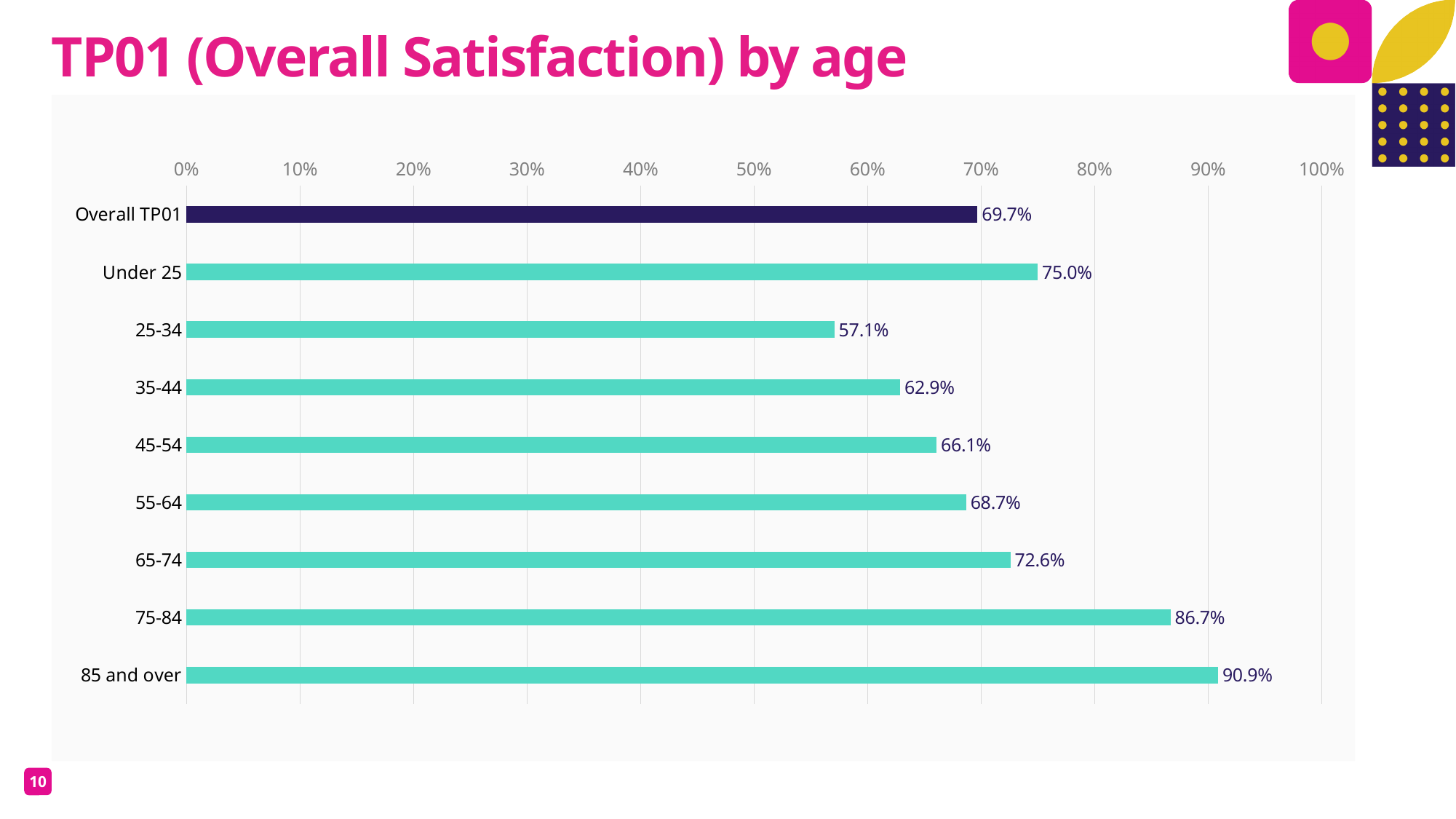
What kind of chart is shown on the slide? bar chart What is the title of the slide? TP01 (Overall Satisfaction) by age Which is larger, the value for 65-74 or the value for 55-64? 65-74 What is the difference between the values for 85 and over and 25-34? 33.8% Which category has the lowest value? 25-34 What is the value for Overall TP01? 69.7% What is the difference between the values for Under 25 and 35-44? 12.1% How many bars are shown on the chart? 9 What is the value for the 75-84 age group? 86.7% Is the value for 45-54 greater or less than 70%? less Which category has the highest value? 85 and over What is the value for the 25-34 age group? 57.1%